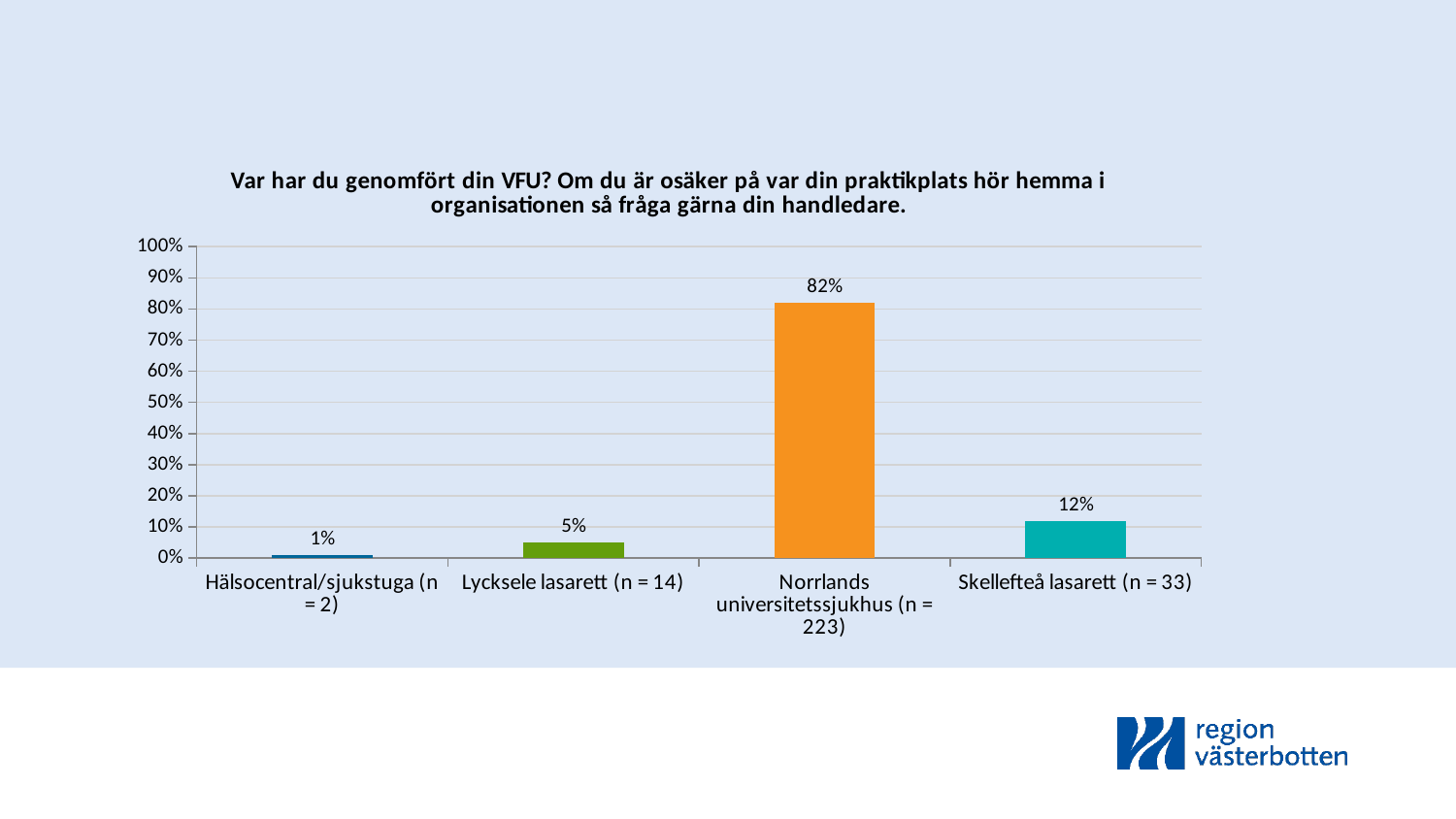
What is the value for Norrlands universitetssjukhus (n = 223)? 82% What is the difference between the values for Norrlands universitetssjukhus (n = 223) and Skellefteå lasarett (n = 33)? 70% Which category has the lowest value? Hälsocentral/sjukstuga (n = 2) What colour is the bar for Norrlands universitetssjukhus (n = 223)? orange Is the value for Norrlands universitetssjukhus (n = 223) greater or less than 80%? greater What is the value for Hälsocentral/sjukstuga (n = 2)? 1% What kind of chart is shown on the slide? bar chart What is the value for Skellefteå lasarett (n = 33)? 12% How many categories are shown on the x axis? 4 Which category has the highest value? Norrlands universitetssjukhus (n = 223) Which is larger, the value for Skellefteå lasarett (n = 33) or the value for Lycksele lasarett (n = 14)? Skellefteå lasarett (n = 33) What is the value for Lycksele lasarett (n = 14)? 5%